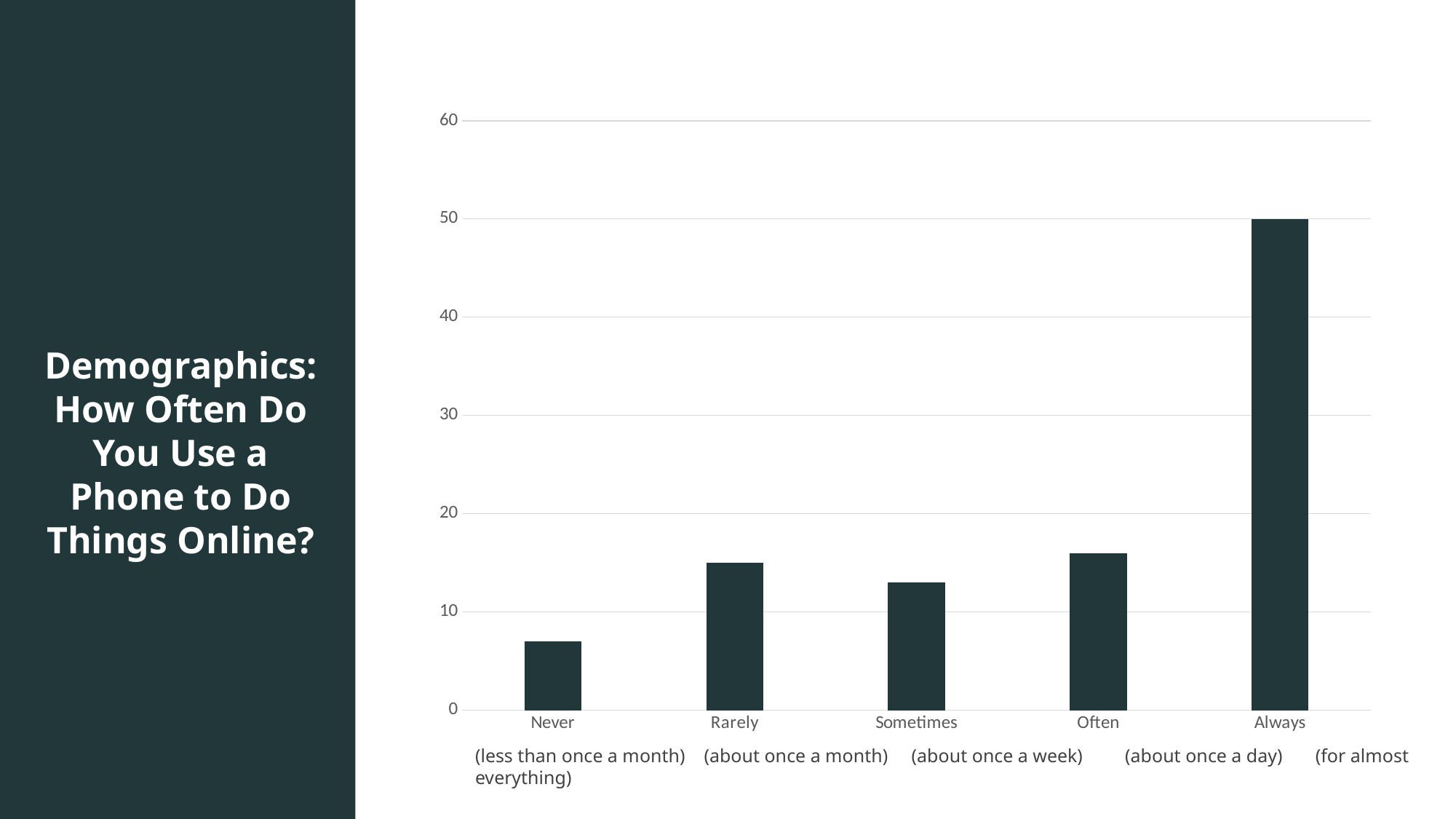
Which is larger, the value for Always or the value for Often? Always What is the title shown on the left of the slide? Demographics: How Often Do You Use a Phone to Do Things Online? Which is larger, the value for Never or the value for Rarely? Rarely Which category has the lowest bar? Never Is the value for Never greater or less than 10? less Is the value for Often greater or less than 20? less How many categories are shown on the x axis of the chart? 5 Is the value for Rarely greater or less than 10? greater What is the value for Always? 50 Which category has the highest bar? Always What kind of chart is shown on the slide? bar chart